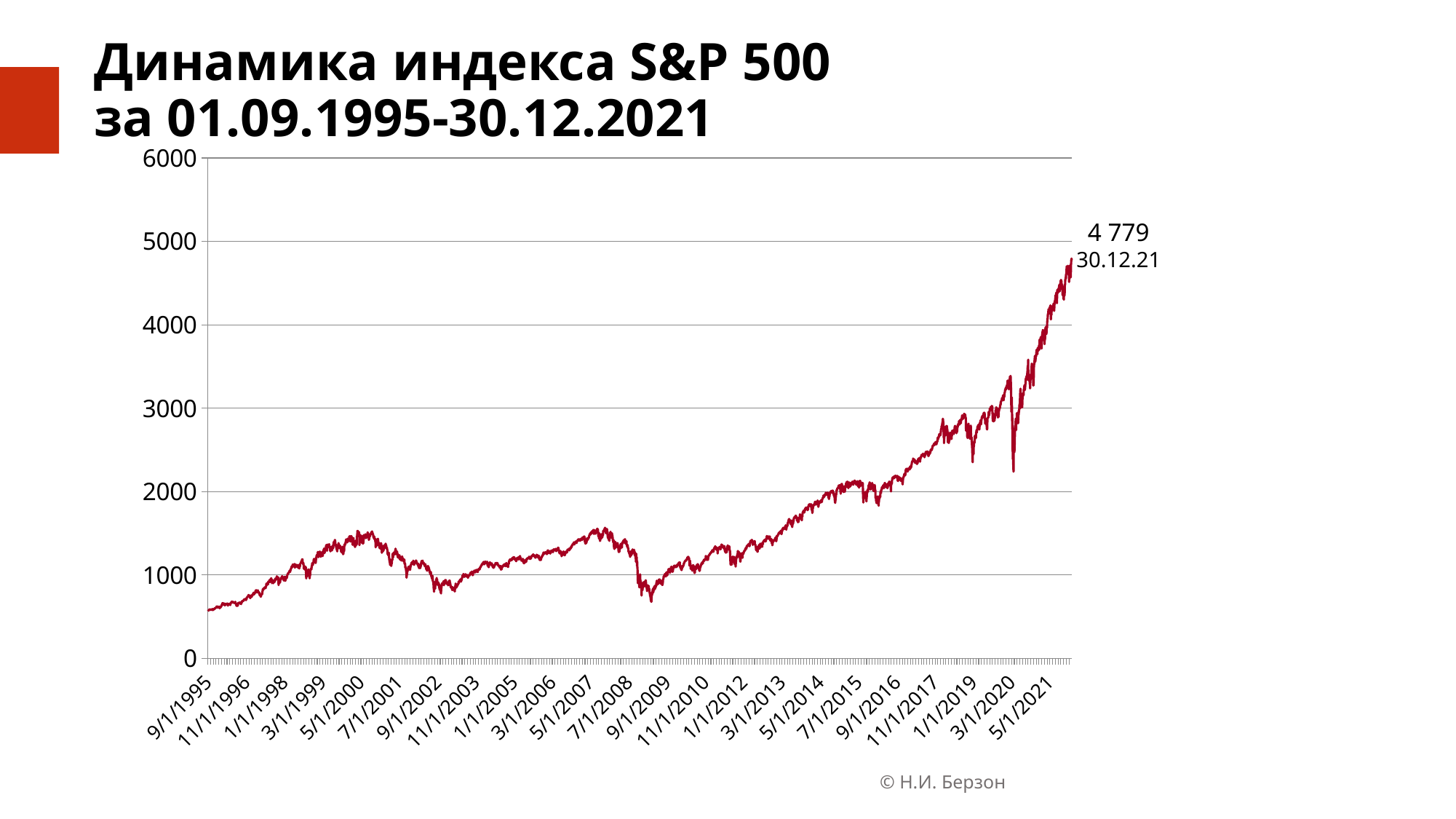
What is the title of the chart? Динамика индекса S&P 500 за 01.09.1995-30.12.2021 What is the highest value shown on the vertical axis? 6000 Is the value of the index at 9/1/1995 greater or less than 1000? less Is the value of the index at 1/1/2012 greater or less than 2000? less Is the value of the index at 9/1/2009 greater or less than 2000? less What value of the S&P 500 index is labelled at 30.12.21? 4 779 Overall, does the S&P 500 index rise or fall from 1995 to 2021 along the x axis? rise What kind of chart is shown on the slide? line chart